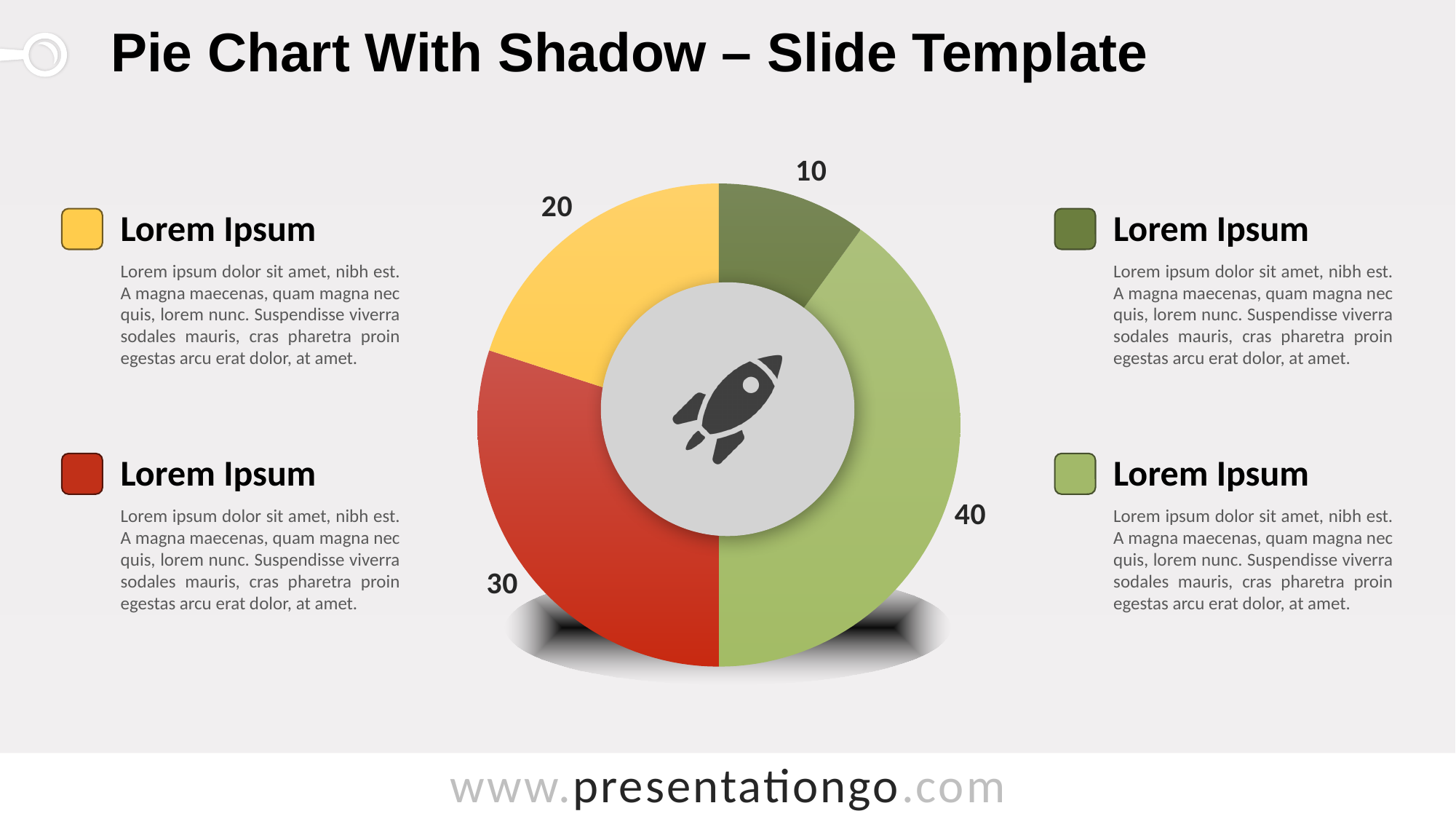
What is the total of all the slice values? 100 Which slice has the smallest value? the dark green slice (10) What type of chart is shown on the slide? pie chart What is the value of the yellow slice? 20 Which slice has the largest value? the light green slice (40) What is the difference between the light green slice and the yellow slice? 20 What is the value of the red slice? 30 What is the value of the light green slice? 40 What share of the total does the red slice represent? 30% How many slices does the pie chart have? 4 Which is larger, the red slice or the yellow slice? the red slice What is the value of the dark green slice? 10